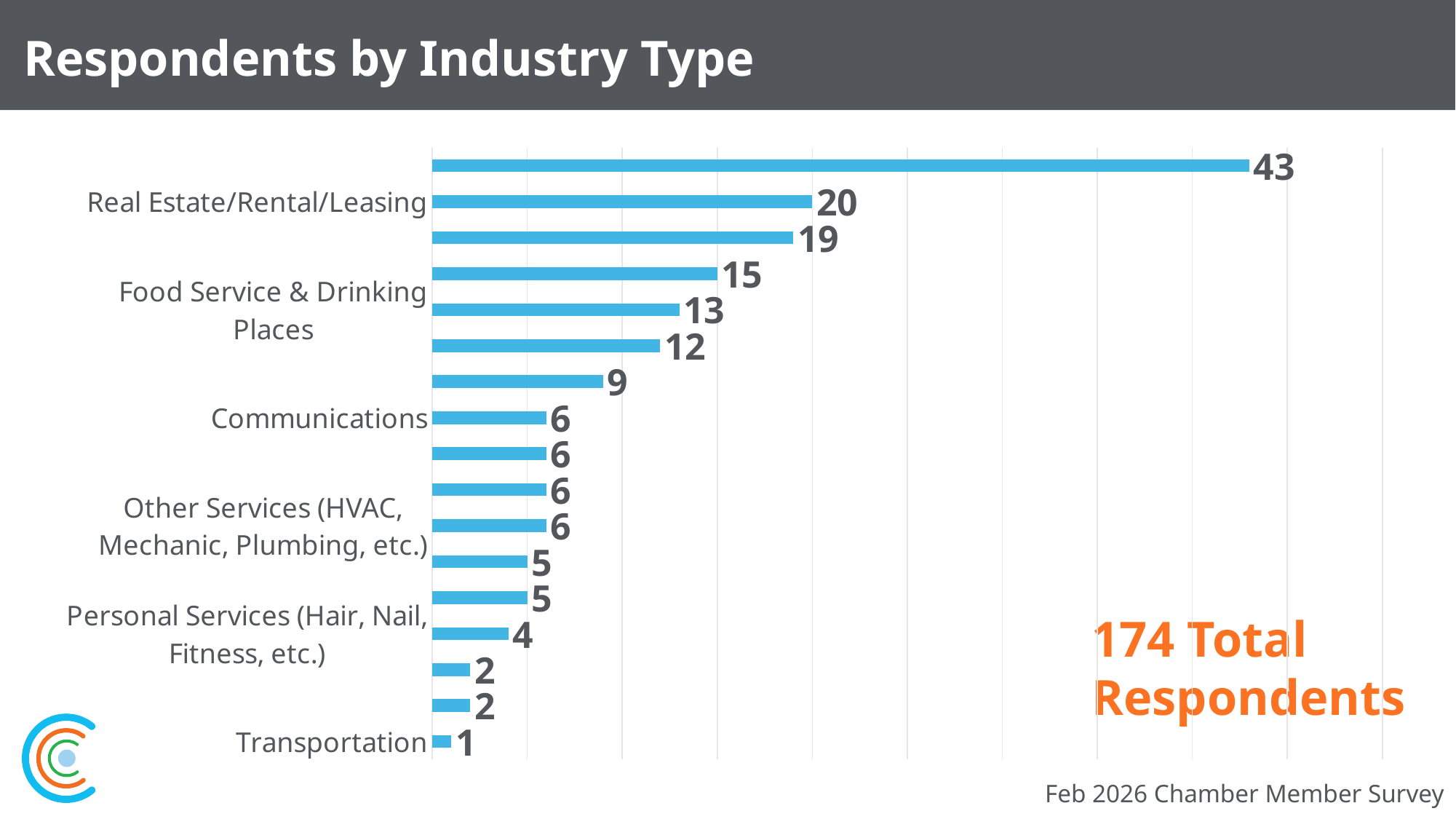
What is the highest value shown on the chart? 43 Which is larger, Communications or Personal Services (Hair, Nail, Fitness, etc.)? Communications What is the value for Personal Services (Hair, Nail, Fitness, etc.)? 4 What kind of chart is shown? Bar chart What is the value for Transportation? 1 Which labelled category has the lowest value? Transportation What is the value for Food Service & Drinking Places? 13 What is the total number of respondents stated on the slide? 174 What is the value for Real Estate/Rental/Leasing? 20 How many bars are plotted on the chart? 17 What is the value for Communications? 6 What is the difference between Real Estate/Rental/Leasing and Food Service & Drinking Places? 7